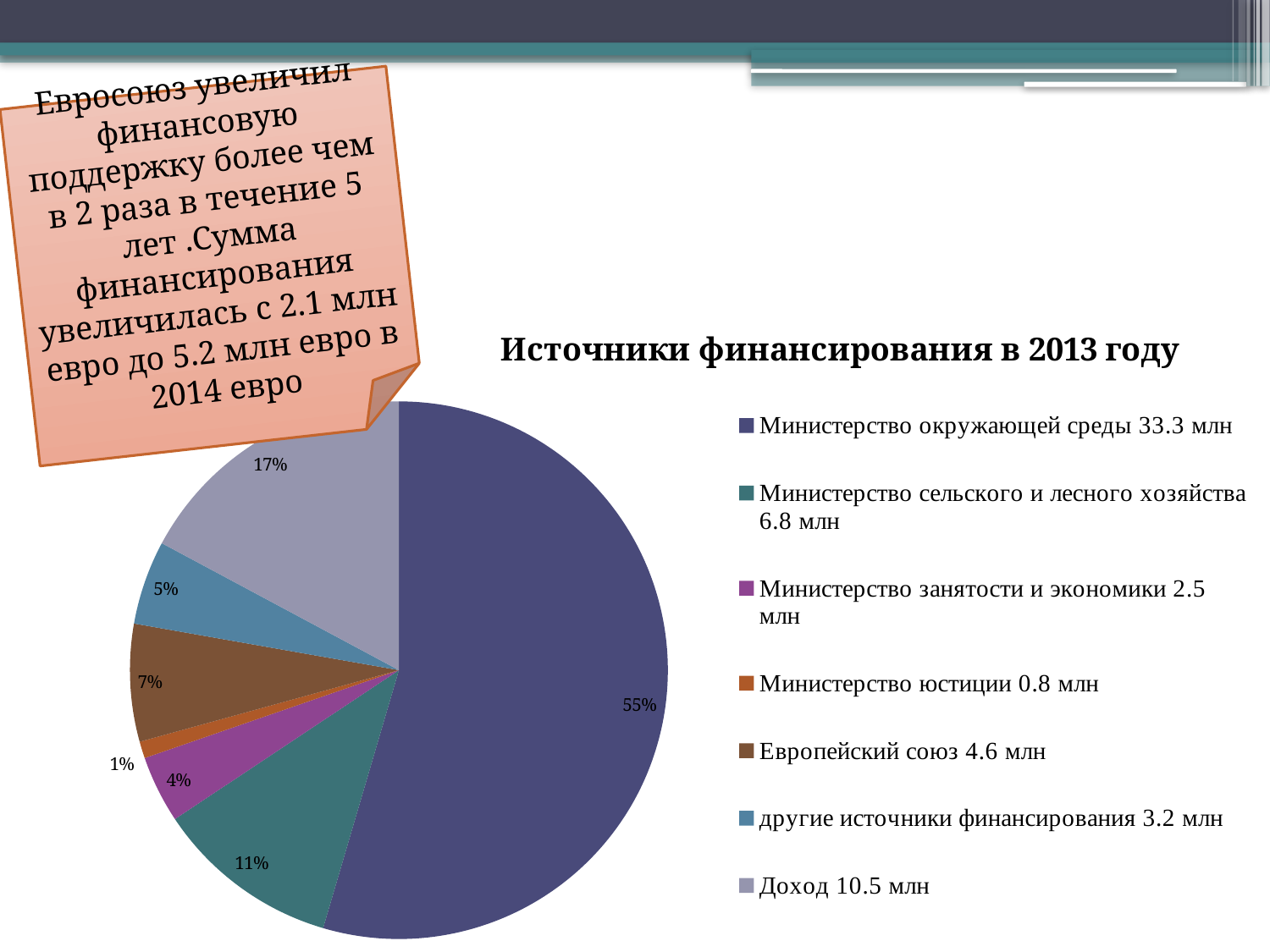
What share of the pie does Министерство сельского и лесного хозяйства have? 11% What type of chart is shown on the slide? pie chart What share of the pie does Министерство юстиции have? 1% Which has a larger share: Европейский союз or другие источники финансирования? Европейский союз Which source of funding has the largest share of the pie? Министерство окружающей среды What share of the pie does Европейский союз have? 7% How many slices does the pie chart have? 7 What is the title of the chart? Источники финансирования в 2013 году Which source of funding has the smallest share of the pie? Министерство юстиции What is the difference in percentage points between the shares of Доход and Министерство сельского и лесного хозяйства? 6